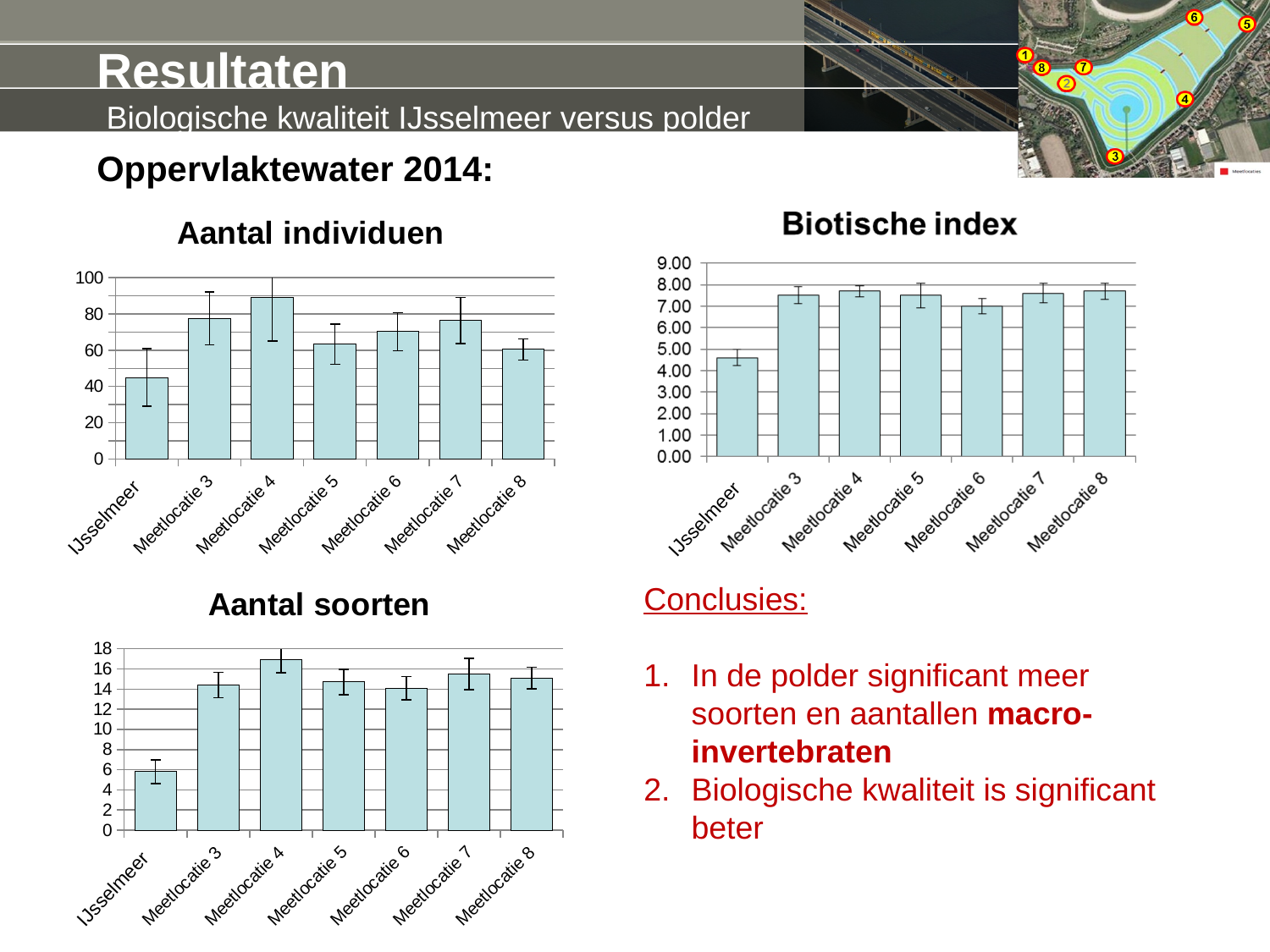
How many categories are shown on the x axis of the 'Biotische index' chart? 7 In the 'Aantal soorten' chart, is the value for IJsselmeer greater or less than 8? less In the 'Aantal individuen' chart, which category has the lowest value? IJsselmeer In the 'Biotische index' chart, is the value for IJsselmeer greater or less than 5.00? less What kind of chart is the 'Aantal soorten' chart? bar chart In the 'Aantal individuen' chart, which is larger, the value for Meetlocatie 3 or Meetlocatie 5? Meetlocatie 3 In the 'Aantal soorten' chart, which category has the highest value? Meetlocatie 4 In the 'Biotische index' chart, which category has the lowest value? IJsselmeer In the 'Aantal individuen' chart, is the value for IJsselmeer greater or less than 60? less In the 'Aantal individuen' chart, which category has the highest value? Meetlocatie 4